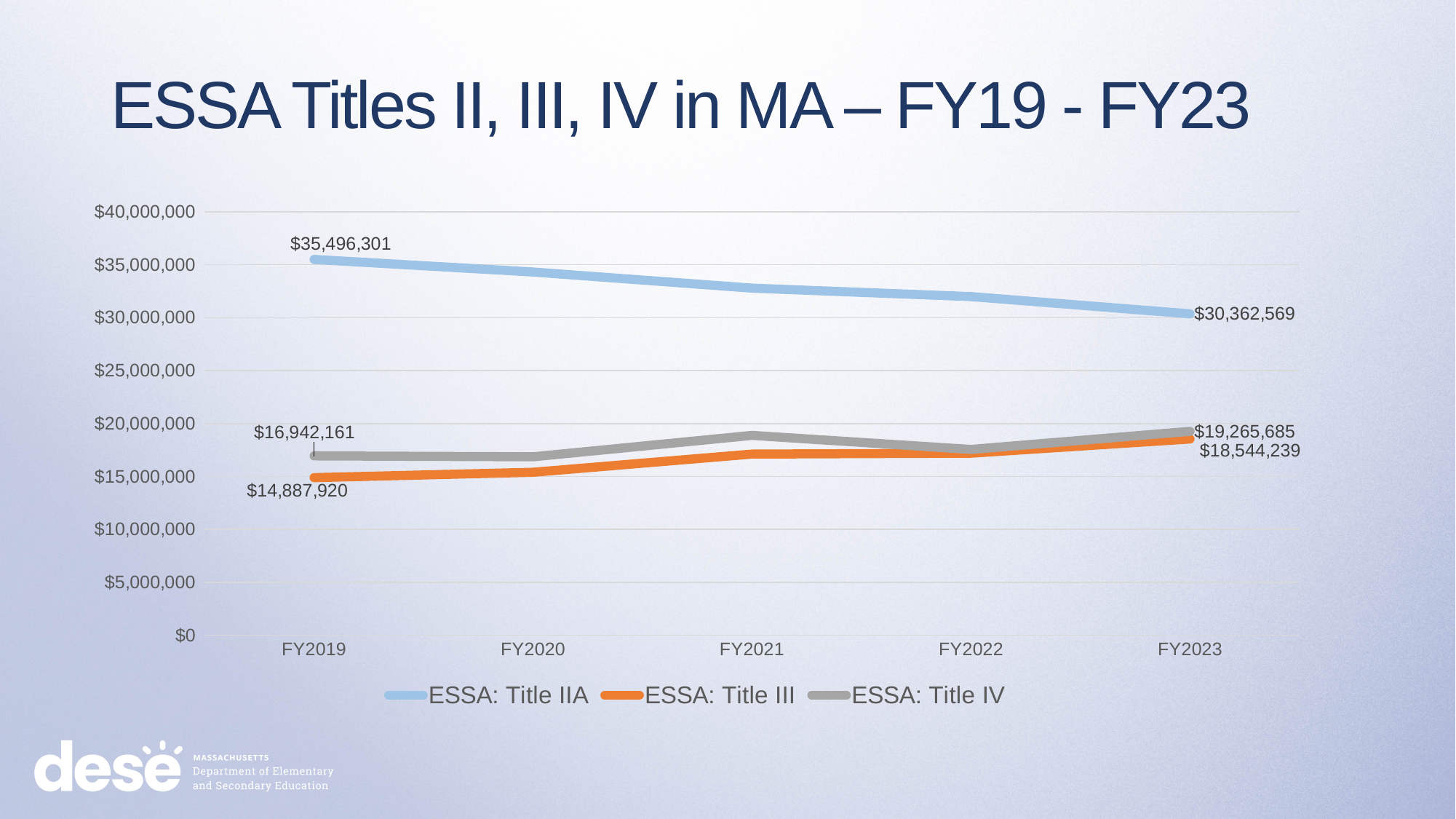
What type of chart is shown on the slide? Line chart How many series does the legend list? 3 Does the ESSA: Title IIA line rise or fall from FY2019 to FY2023? Fall Which series has the highest value in FY2023? ESSA: Title IIA How many fiscal years are shown on the x axis? 5 What is the value for ESSA: Title III in FY2019? $14,887,920 By how much did ESSA: Title IIA decrease from FY2019 to FY2023? $5,133,732 Which series has the lowest value in FY2019? ESSA: Title III What is the value for ESSA: Title IIA in FY2019? $35,496,301 What is the value for ESSA: Title IV in FY2023? $19,265,685 Is the value for ESSA: Title IIA in FY2021 greater or less than $30,000,000? greater What is the value for ESSA: Title IIA in FY2023? $30,362,569